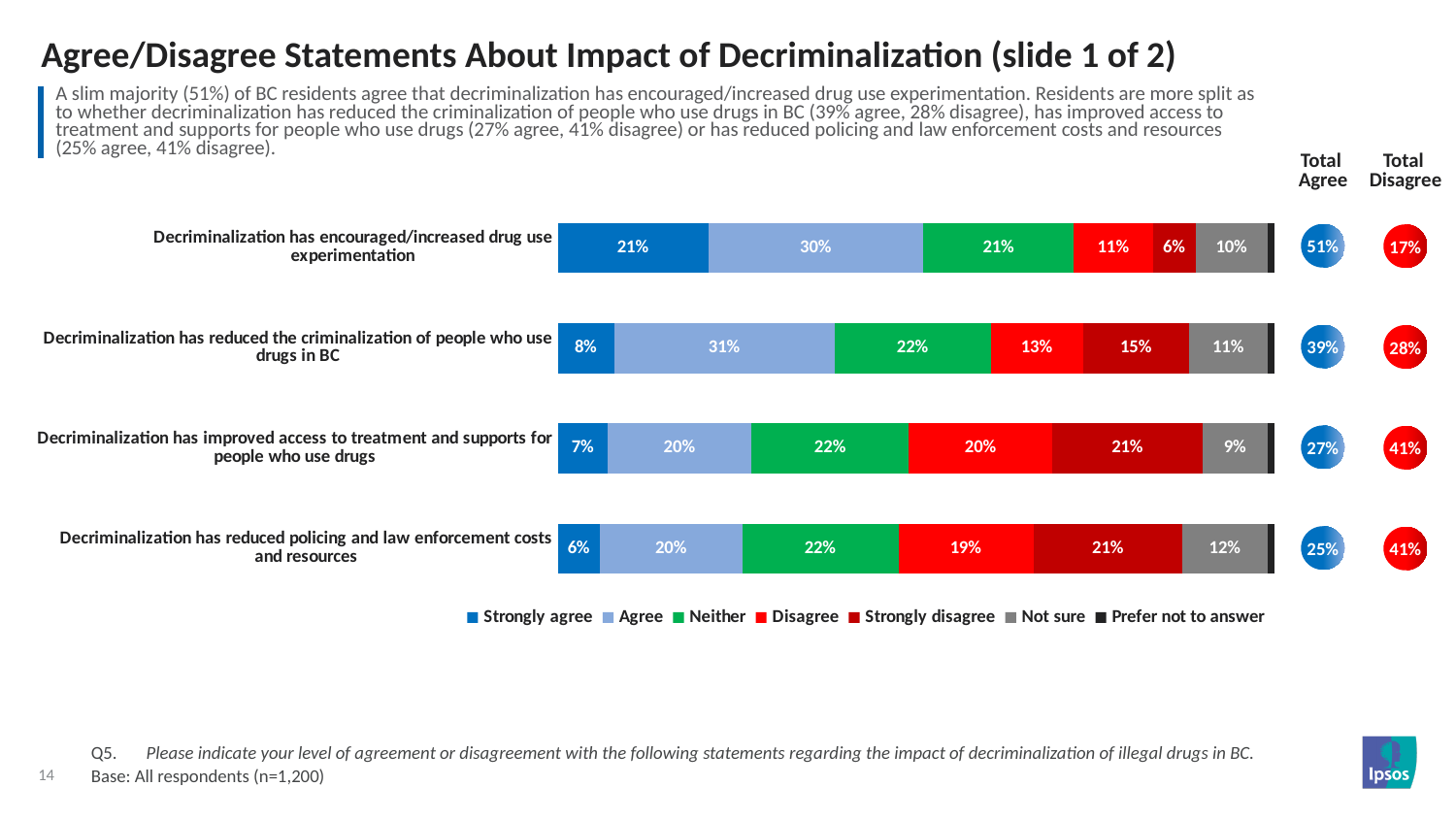
What percentage of respondents strongly agree that decriminalization has encouraged/increased drug use experimentation? 21% How many statements are shown in the chart? 4 Which is larger: the 'Agree' percentage for the statement about reducing the criminalization of people who use drugs, or the 'Agree' percentage for the statement about encouraging/increasing drug use experimentation? Reducing the criminalization of people who use drugs (31%) Which legend entry is shown in green? Neither How many response categories does the legend list? 7 Which statement has the highest 'Strongly agree' percentage? Decriminalization has encouraged/increased drug use experimentation What kind of chart is shown on the slide? Stacked bar chart Which statement has the lowest 'Strongly agree' percentage? Decriminalization has reduced policing and law enforcement costs and resources What is the 'Disagree' percentage for the statement that decriminalization has reduced the criminalization of people who use drugs in BC? 13% What percentage of respondents answered 'Not sure' for the statement that decriminalization has reduced policing and law enforcement costs and resources? 12% What is the 'Strongly disagree' percentage for the statement that decriminalization has improved access to treatment and supports for people who use drugs? 21% What is the difference in 'Strongly agree' percentage between the statement about encouraging/increasing drug use experimentation and the statement about reducing policing and law enforcement costs? 15 percentage points